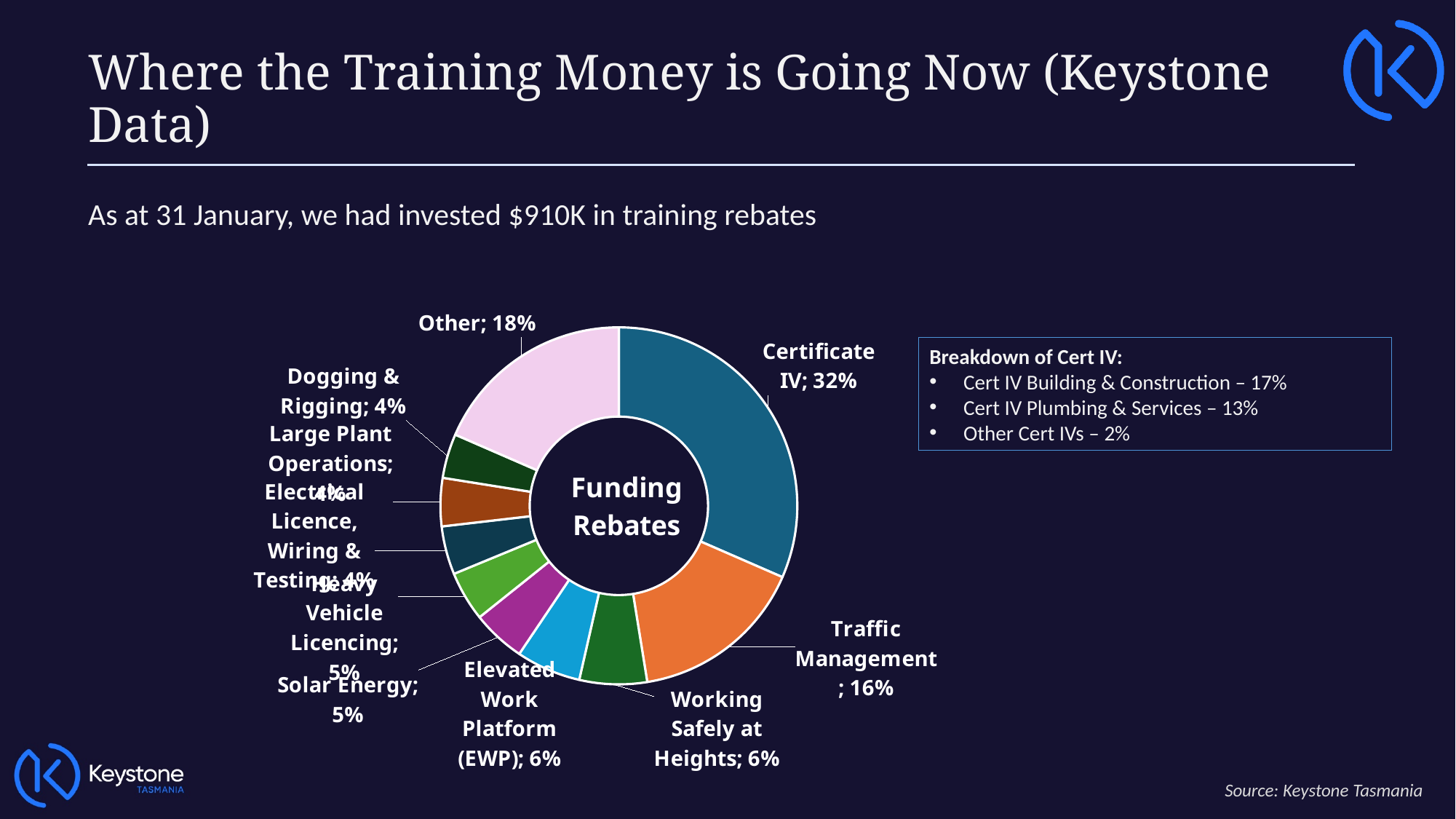
How many percentage points larger is the Certificate IV share than the Traffic Management share? 16 percentage points What percentage is shown for Solar Energy? 5% Which slice is larger, Other or Traffic Management? Other What kind of chart is shown on the slide? pie chart (donut) What percentage of funding rebates went to Traffic Management? 16% What percentage is shown for Dogging & Rigging? 4% Which category has the largest share of the funding rebates? Certificate IV What percentage of funding rebates went to Certificate IV? 32% What text appears in the centre of the donut chart? Funding Rebates How many slices does the pie chart have? 10 What percentage is shown for Working Safely at Heights? 6% What percentage is shown for the Other slice? 18%